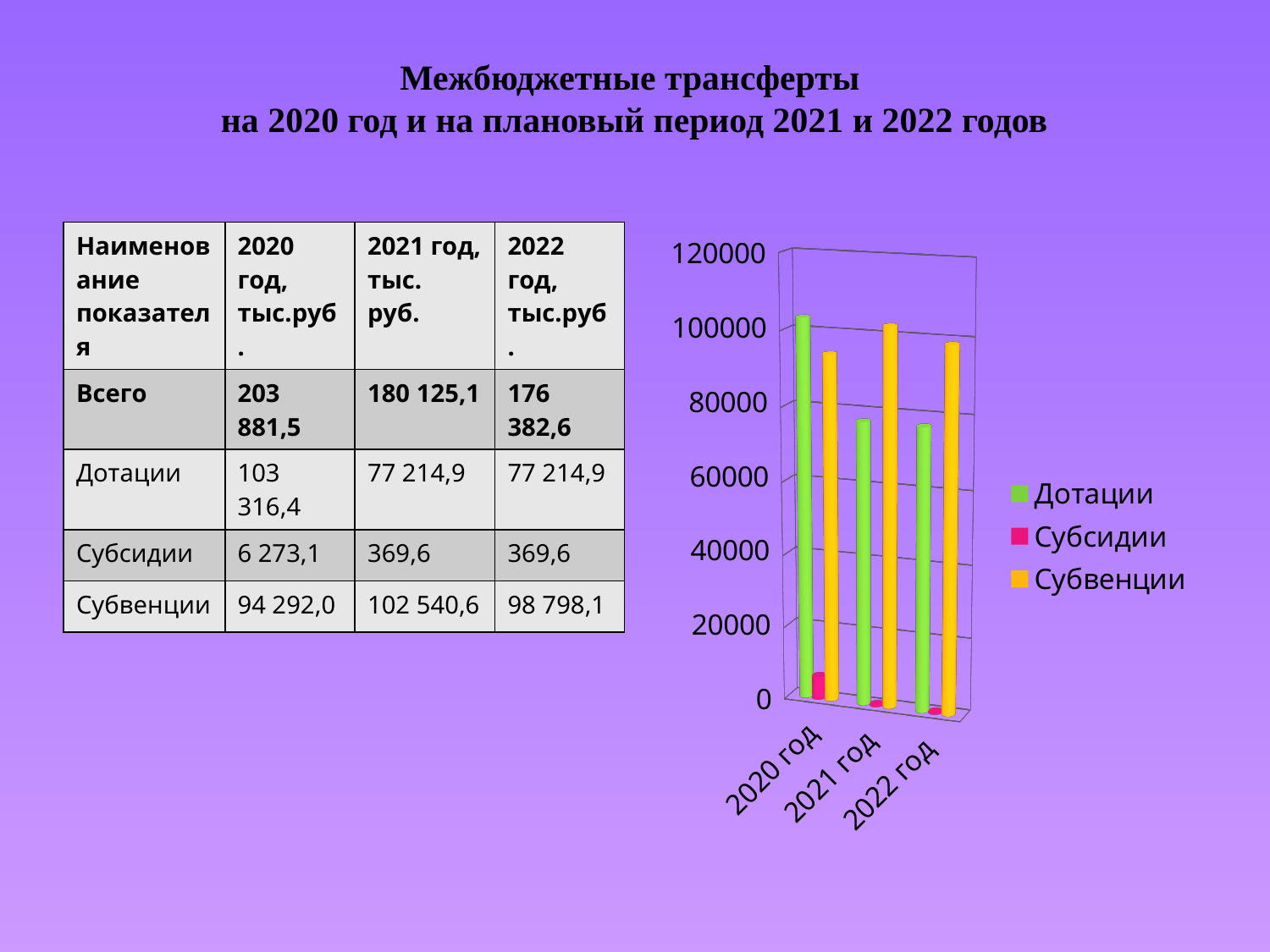
In 2020 год, which is larger: Дотации or Субвенции? Дотации In 2021 год, which is larger: Дотации or Субвенции? Субвенции Which series is shown in green in the chart? Дотации In which year is the Дотации bar highest? 2020 год Which series has the lowest bars in every year? Субсидии Is the value for Субсидии in 2020 год greater or less than 20000? less Is the value for Дотации in 2021 год greater or less than 60000? greater In which year is the Субвенции bar highest? 2021 год How many series does the chart legend list? 3 Do the Дотации values rise or fall from 2020 год to 2021 год? fall What kind of chart is shown on the slide? bar chart How many year categories are shown on the x axis of the chart? 3